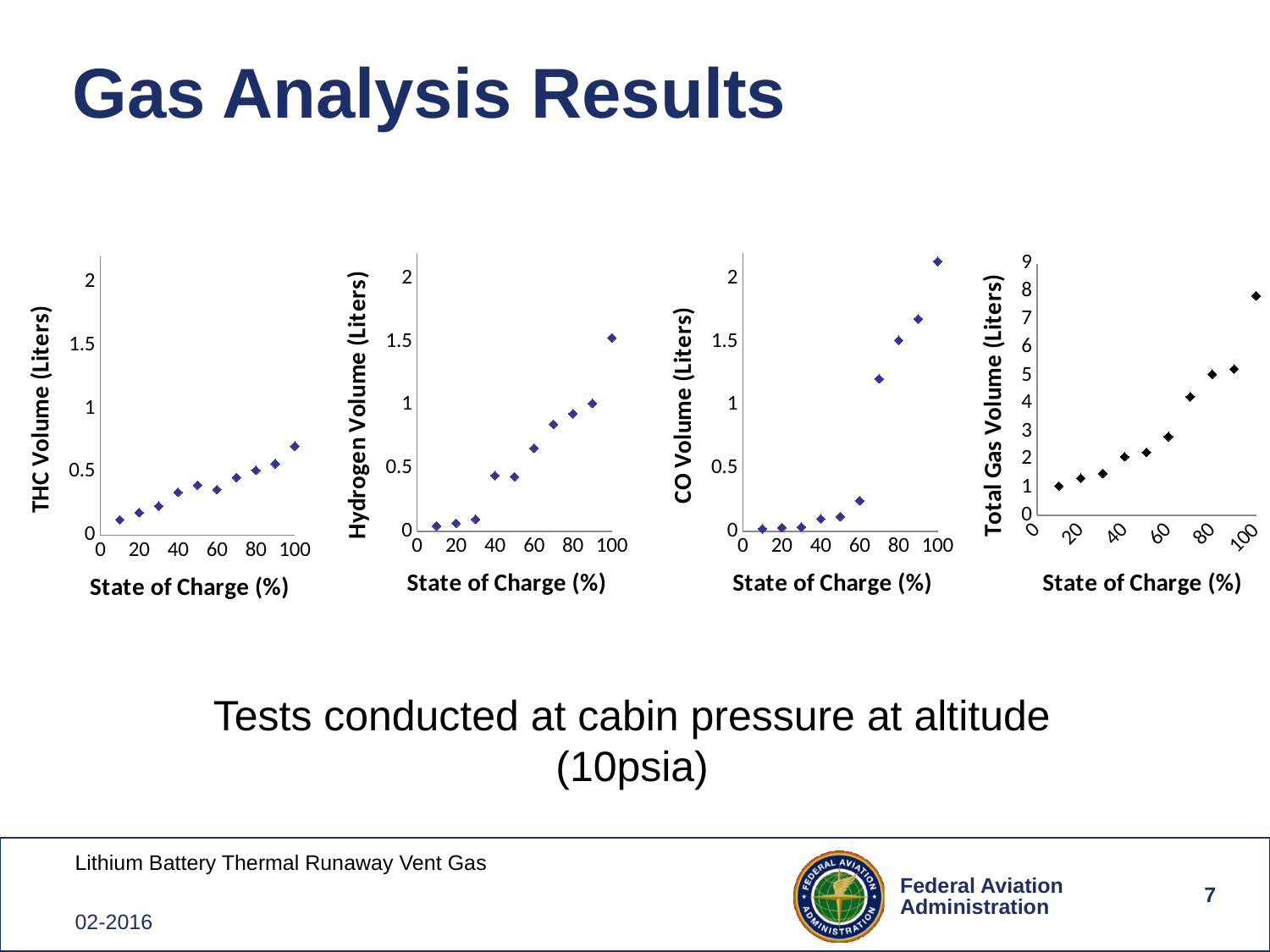
In the Total Gas Volume chart, is the value at 100% State of Charge greater or less than 7? greater In the THC Volume chart, at which State of Charge is the volume lowest? 10 What kind of chart is the THC Volume chart? scatter chart How many data points are plotted in the Total Gas Volume chart? 10 In the Hydrogen Volume chart, is the value at 100% State of Charge greater or less than 1? greater In the CO Volume chart, is the value at 60% State of Charge greater or less than 0.5? less In the Total Gas Volume chart, at which State of Charge is the volume highest? 100 How many data points are plotted in the Hydrogen Volume chart? 10 In the CO Volume chart, do the values rise or fall as State of Charge increases? rise What is the x-axis label shared by all four charts? State of Charge (%) At 100% State of Charge, which is larger: the Hydrogen Volume or the THC Volume? Hydrogen Volume